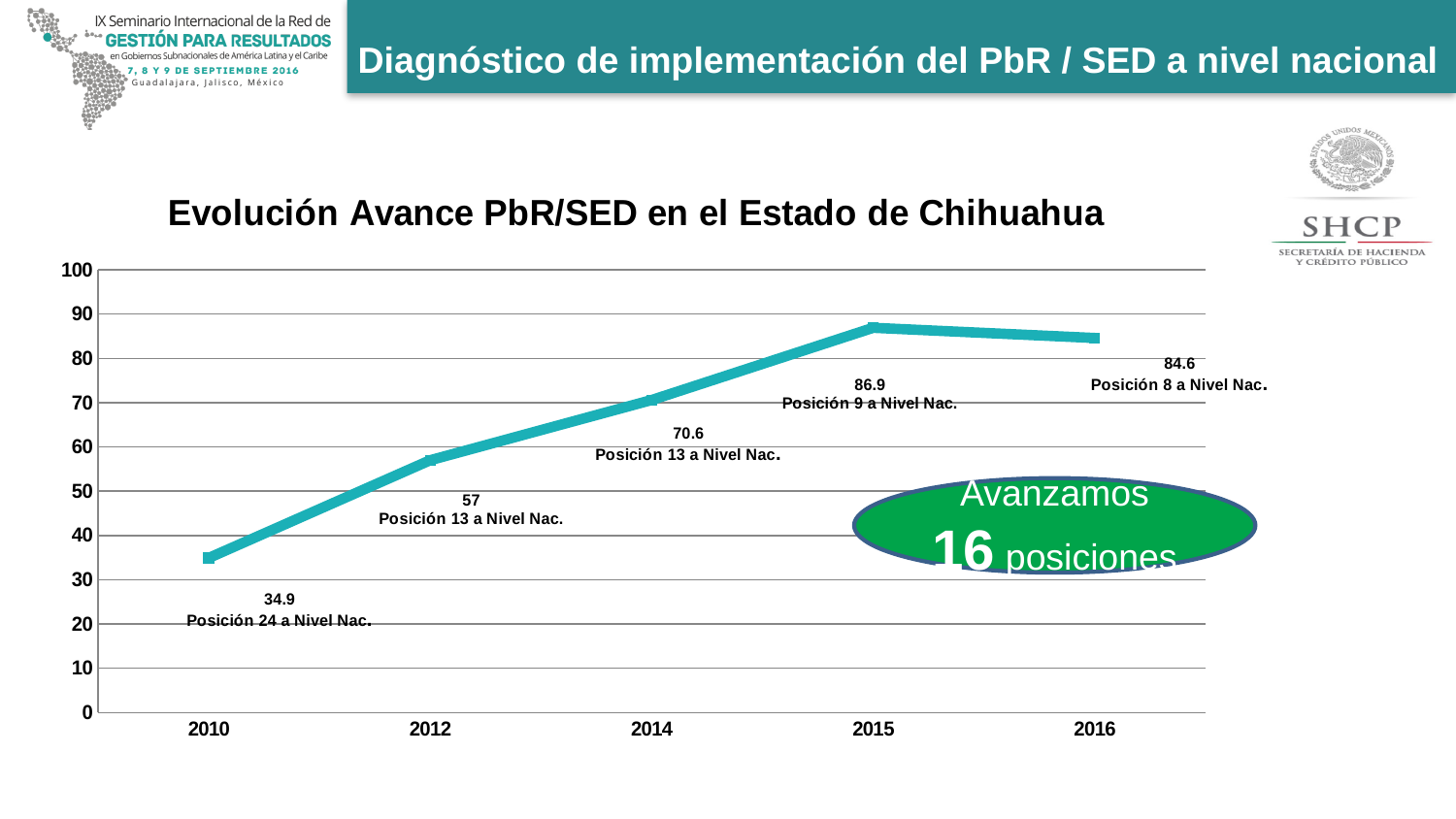
Does the value rise or fall from 2010 to 2015? rise What is the value for 2015 in the chart? 86.9 Is the value for 2012 greater or less than 50? greater Which year has the lowest value in the chart? 2010 What is the value for 2016 in the chart? 84.6 What is the value for 2010 in the chart? 34.9 Which is larger, the value for 2015 or the value for 2016? 2015 What is the title of the chart? Evolución Avance PbR/SED en el Estado de Chihuahua How many years are plotted on the x axis of the chart? 5 What kind of chart is shown on the slide? line chart What is the difference between the values for 2014 and 2012? 13.6 Which year has the highest value in the chart? 2015